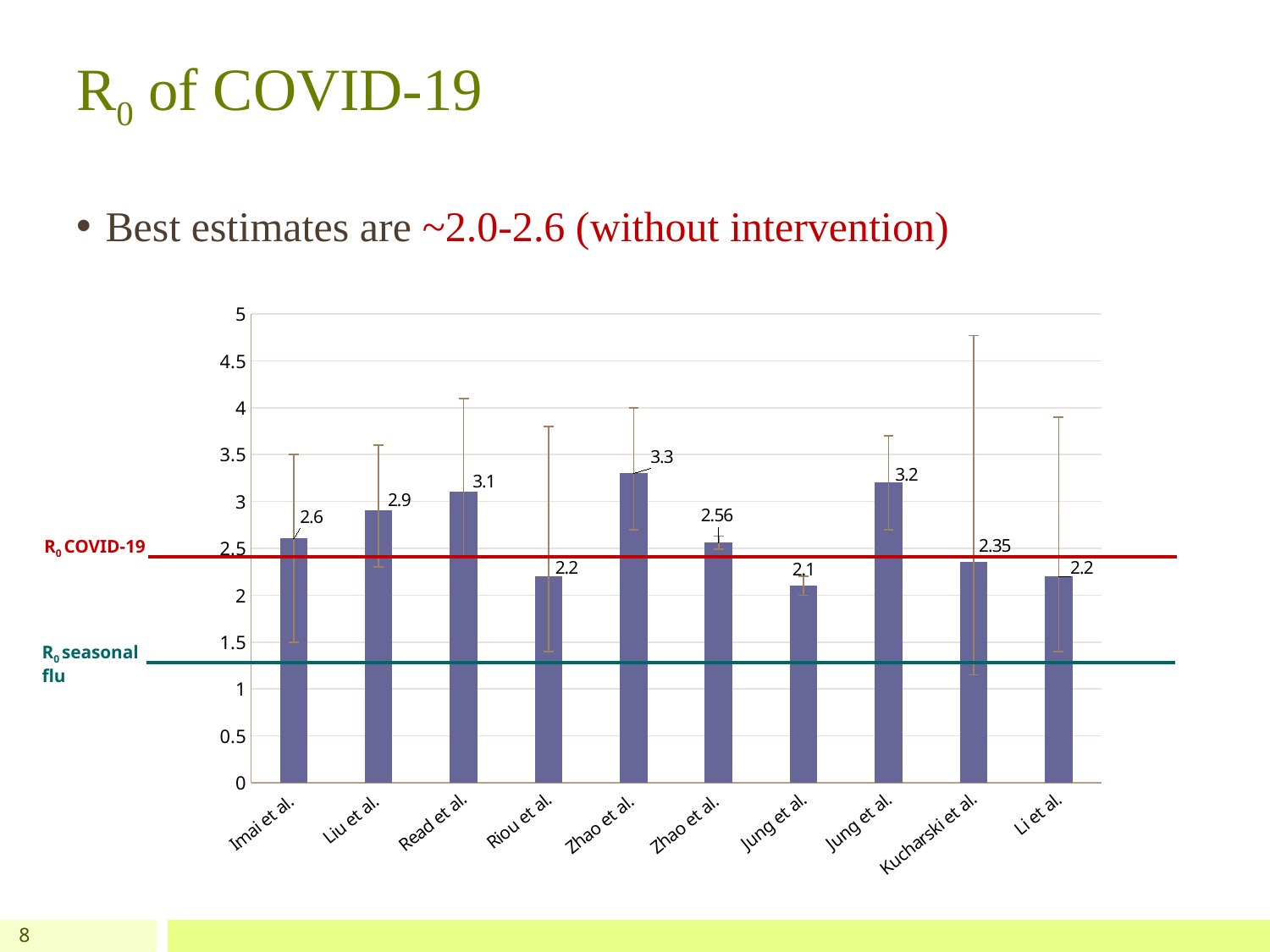
What type of chart is shown on the slide? bar chart What is the R0 value shown for Liu et al.? 2.9 What is the R0 value shown for Kucharski et al.? 2.35 What is the R0 value shown for Read et al.? 3.1 Which has a higher R0 estimate, Liu et al. or Kucharski et al.? Liu et al. What does the red horizontal line on the chart represent? R0 COVID-19 What is the difference between the R0 values for Read et al. and Riou et al.? 0.9 Is the value for Li et al. greater or less than 2.5? less How many bars (studies) are plotted in the chart? 10 What is the lowest R0 estimate plotted in the chart? 2.1 What is the R0 value shown for Imai et al.? 2.6 What is the highest R0 estimate plotted in the chart? 3.3